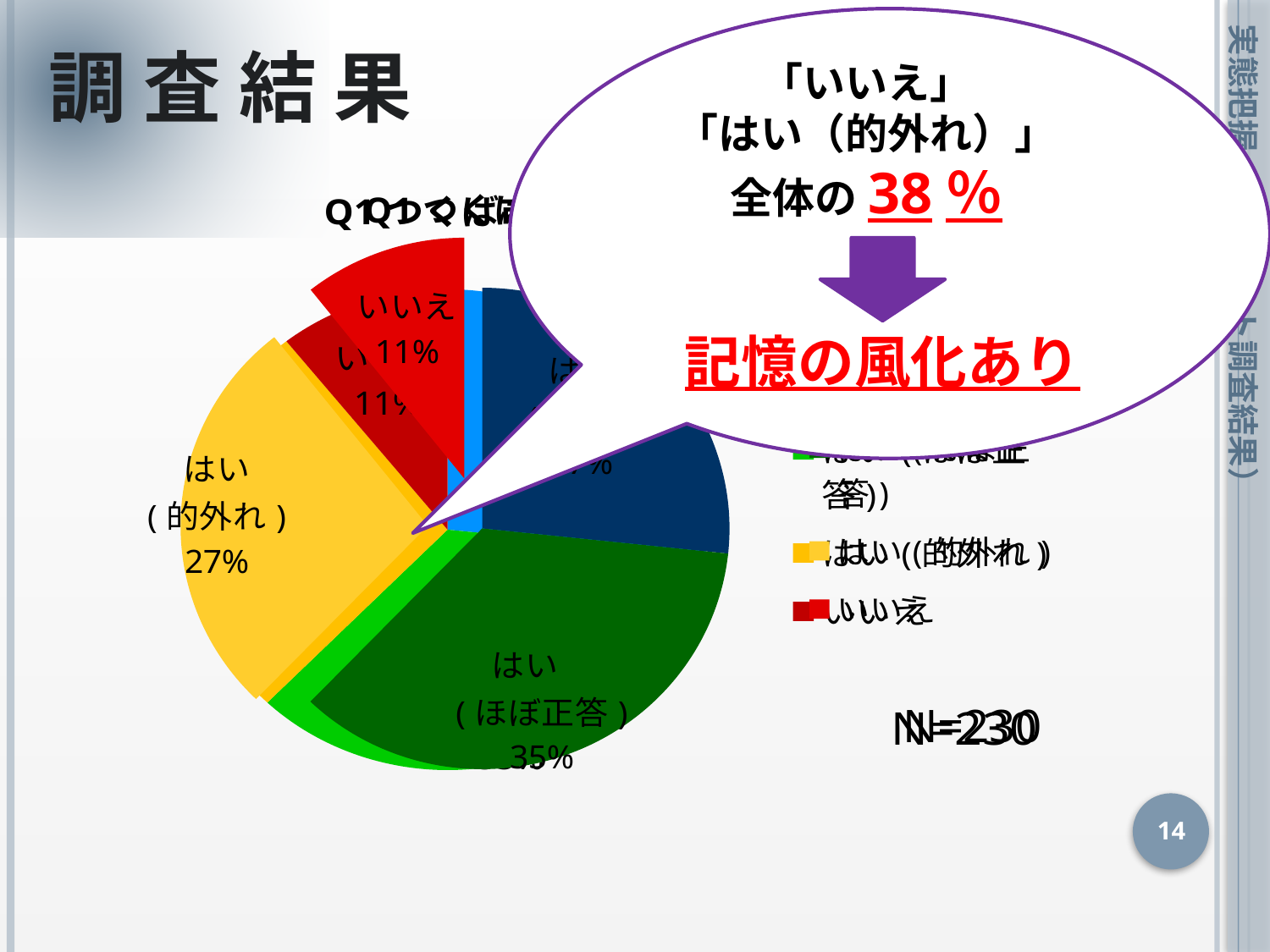
What sample size (N) is shown next to the pie chart? N=230 Which slice is larger, いいえ or はい（的外れ）? はい（的外れ） By how many percentage points does the はい（ほぼ正答） slice exceed the はい（的外れ） slice? 8 What kind of chart is shown on the slide? pie chart What percentage of the pie is the いいえ slice? 11% What colour is the いいえ slice of the pie chart? red What percentage of the pie is the はい（ほぼ正答） slice? 35% By how many percentage points does the はい（的外れ） slice exceed the いいえ slice? 16 What is the combined share of the いいえ and はい（的外れ） slices? 38% Which slice is larger, はい（ほぼ正答） or はい（的外れ）? はい（ほぼ正答） What percentage of the pie is the はい（的外れ） slice? 27%